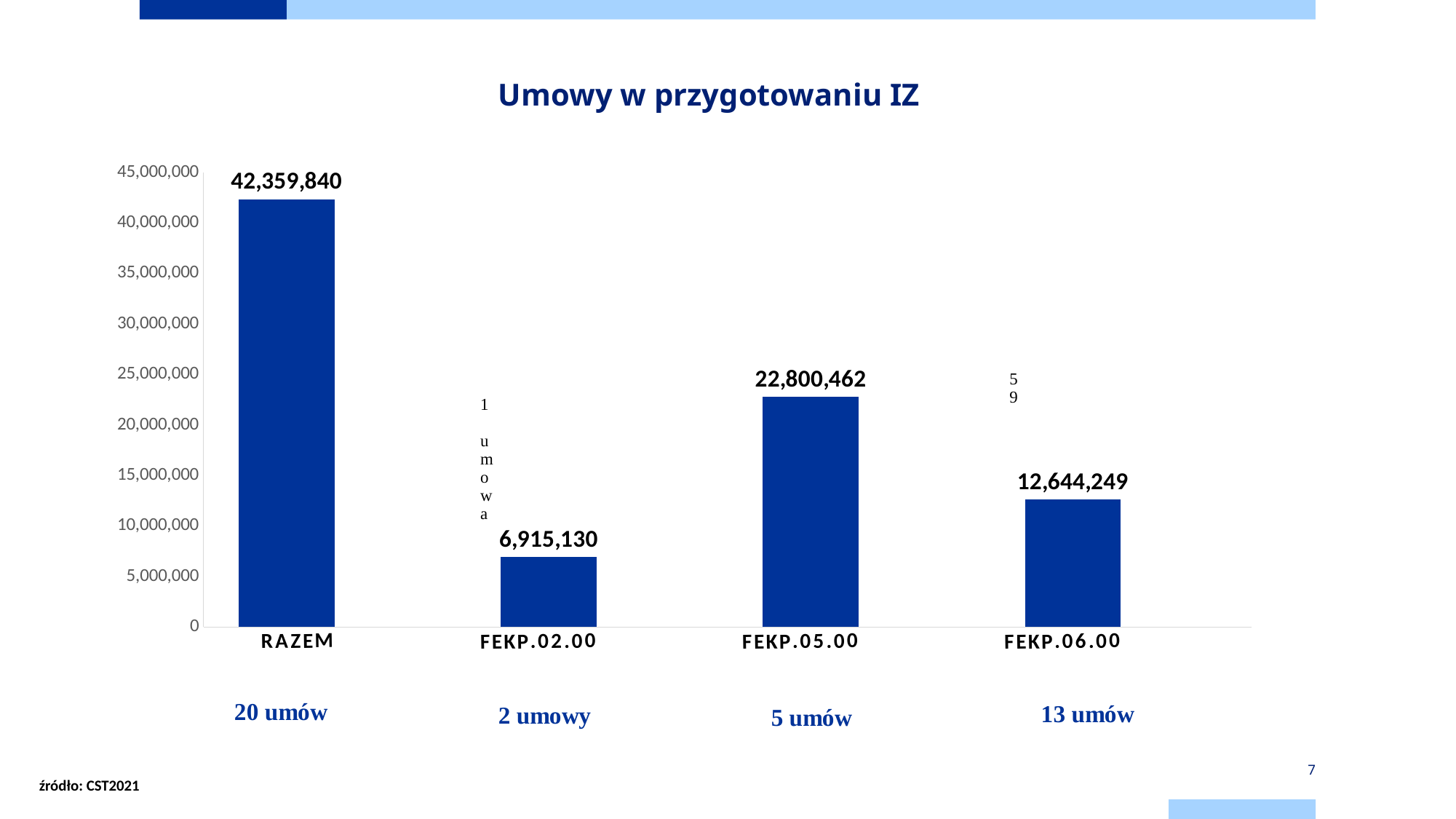
What is the value shown for FEKP.02.00? 6,915,130 What is the difference between the values for FEKP.06.00 and FEKP.02.00? 5,729,119 What is the value shown for RAZEM? 42,359,840 What kind of chart is shown on the slide? bar chart Which category has the lowest value? FEKP.02.00 Which is larger, the value for FEKP.05.00 or the value for FEKP.06.00? FEKP.05.00 What is the difference between the values for FEKP.05.00 and FEKP.06.00? 10,156,213 What is the value shown for FEKP.06.00? 12,644,249 Which category has the highest value? RAZEM What is the title of the chart? Umowy w przygotowaniu IZ What is the value shown for FEKP.05.00? 22,800,462 How many categories are shown on the x axis? 4